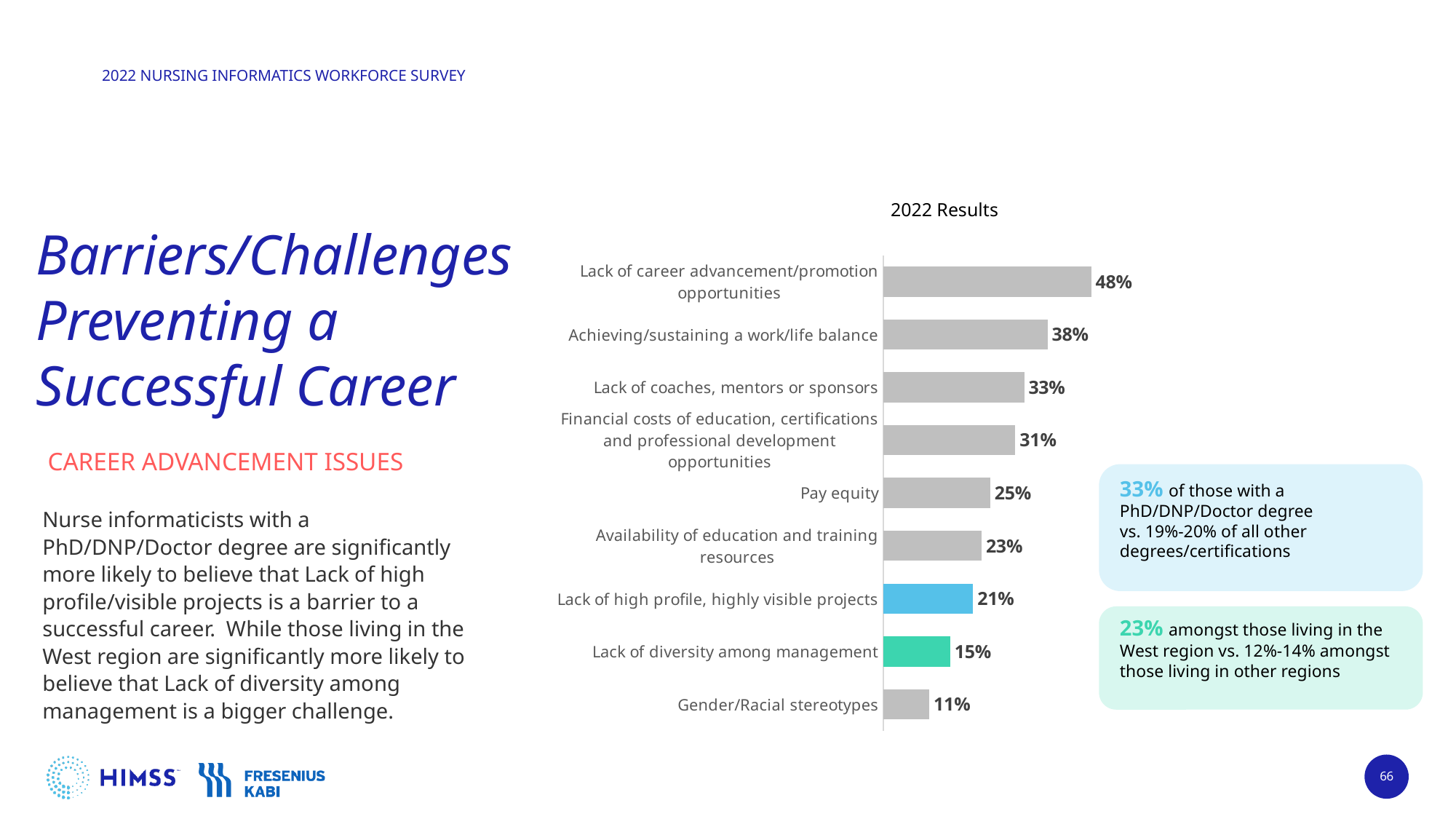
Which category's bar is coloured green? Lack of diversity among management What is the value for Lack of career advancement/promotion opportunities? 48% Which category has the highest value? Lack of career advancement/promotion opportunities What is the value for Lack of diversity among management? 15% Which is larger: Availability of education and training resources or Lack of high profile, highly visible projects? Availability of education and training resources What is the difference between Achieving/sustaining a work/life balance and Lack of coaches, mentors or sponsors? 5% What is the value for Financial costs of education, certifications and professional development opportunities? 31% What is the title of the chart? 2022 Results Which category has the lowest value? Gender/Racial stereotypes What kind of chart is shown on the slide? Bar chart How many categories are shown in the chart? 9 What is the value for Pay equity? 25%